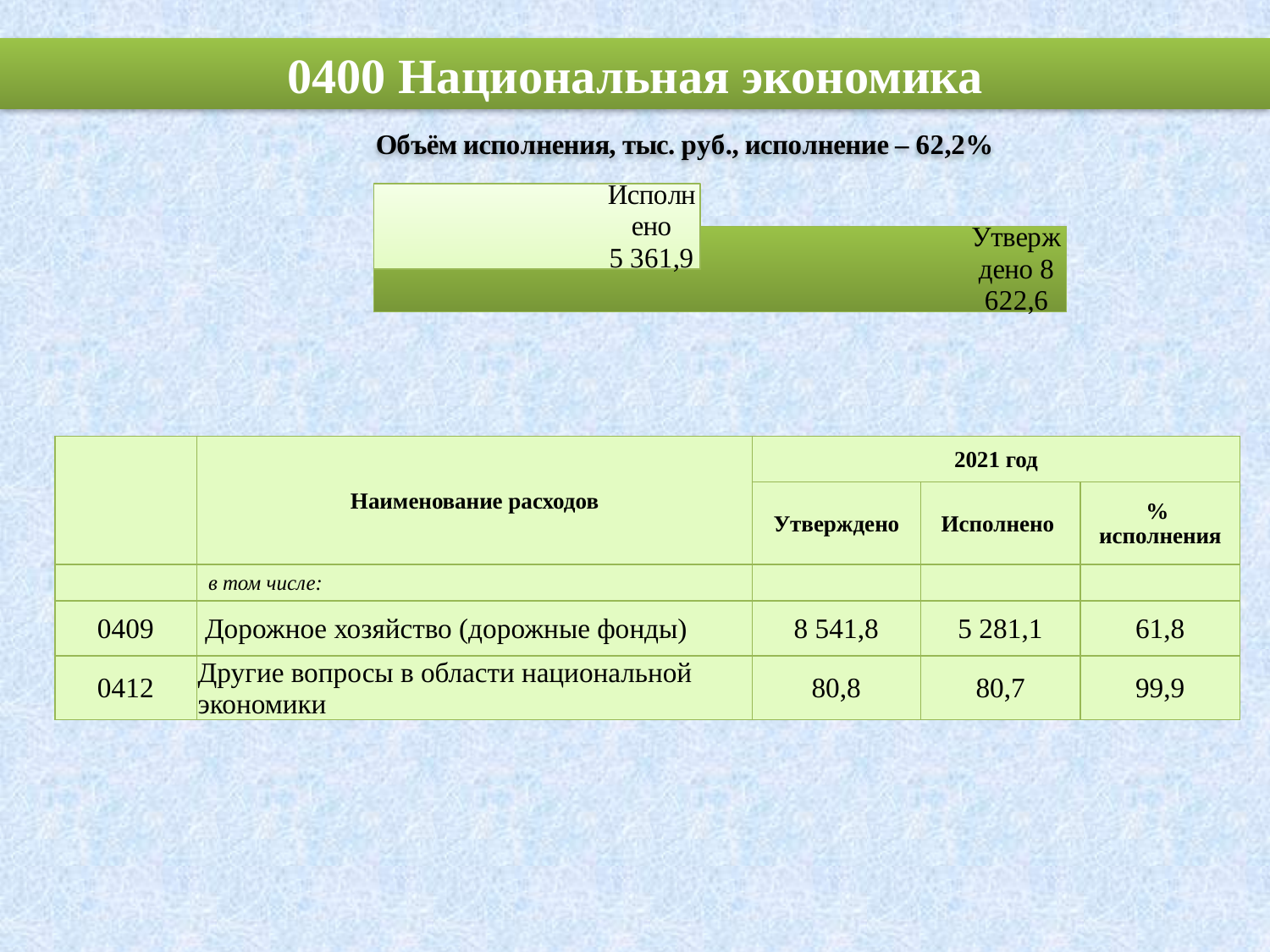
What is the value of the 'Исполнено' bar in the chart? 5 361,9 How many bars does the chart show? 2 What is the value of the 'Утверждено' bar in the chart? 8 622,6 What kind of chart is shown on the slide? Bar chart What is the difference between the 'Утверждено' and 'Исполнено' values in the chart? 3 260,7 What execution percentage is stated in the chart title? 62,2% Which is larger in the chart: 'Утверждено' or 'Исполнено'? Утверждено What is the title of the chart on the slide? Объём исполнения, тыс. руб., исполнение – 62,2% Which bar in the chart is the longest? Утверждено Which bar in the chart is the shortest? Исполнено